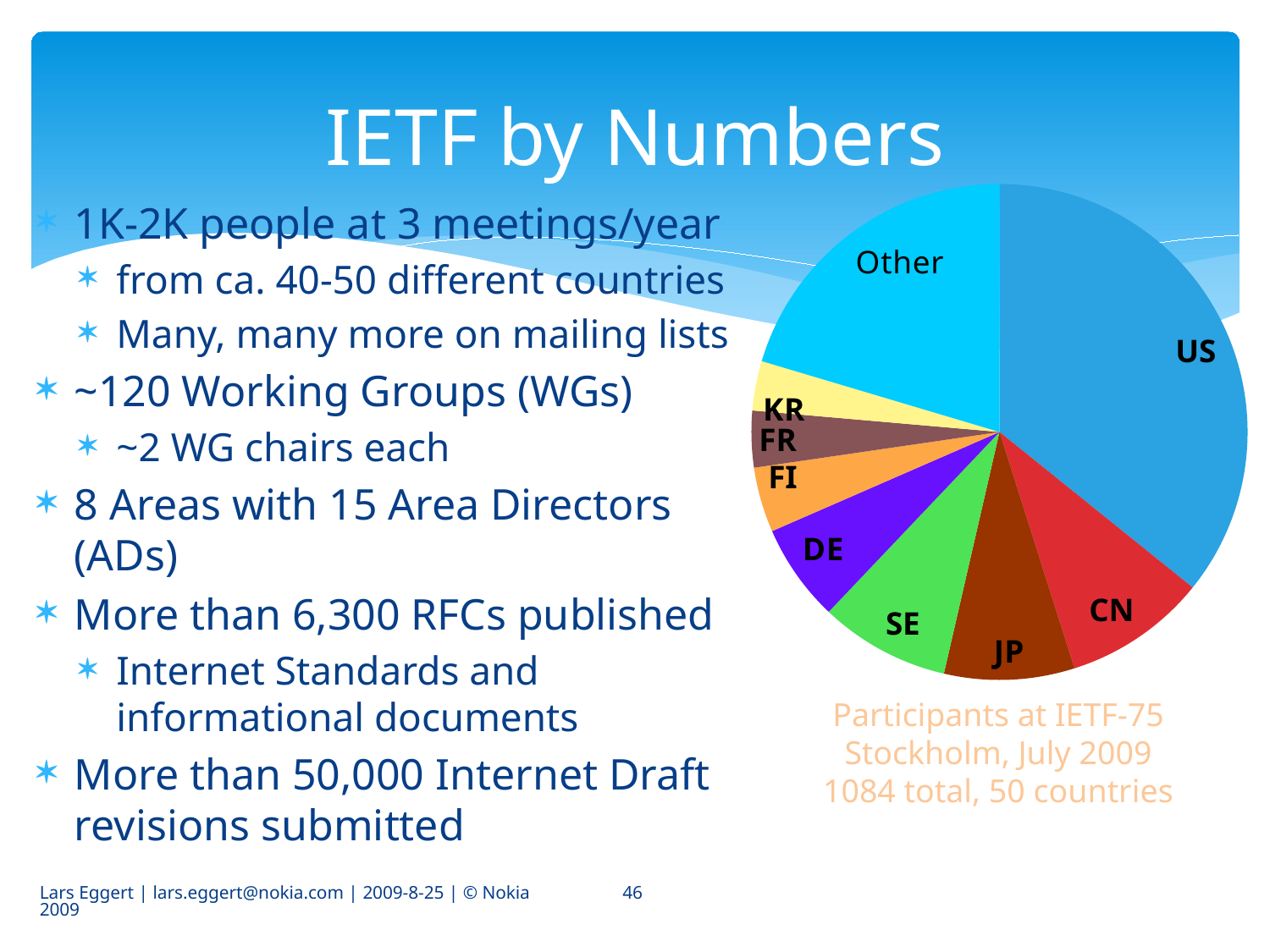
Which slice is larger, CN or FI? CN According to the caption, what is the total number of participants shown in the pie chart? 1084 Which slice is larger, US or Other? US How many slices does the pie chart have? 9 Which slice is larger, US or CN? US Which country has the largest slice of the pie chart? US What kind of chart is shown on the slide? pie chart According to the caption, which meeting does the pie chart show participants for? IETF-75 Stockholm, July 2009